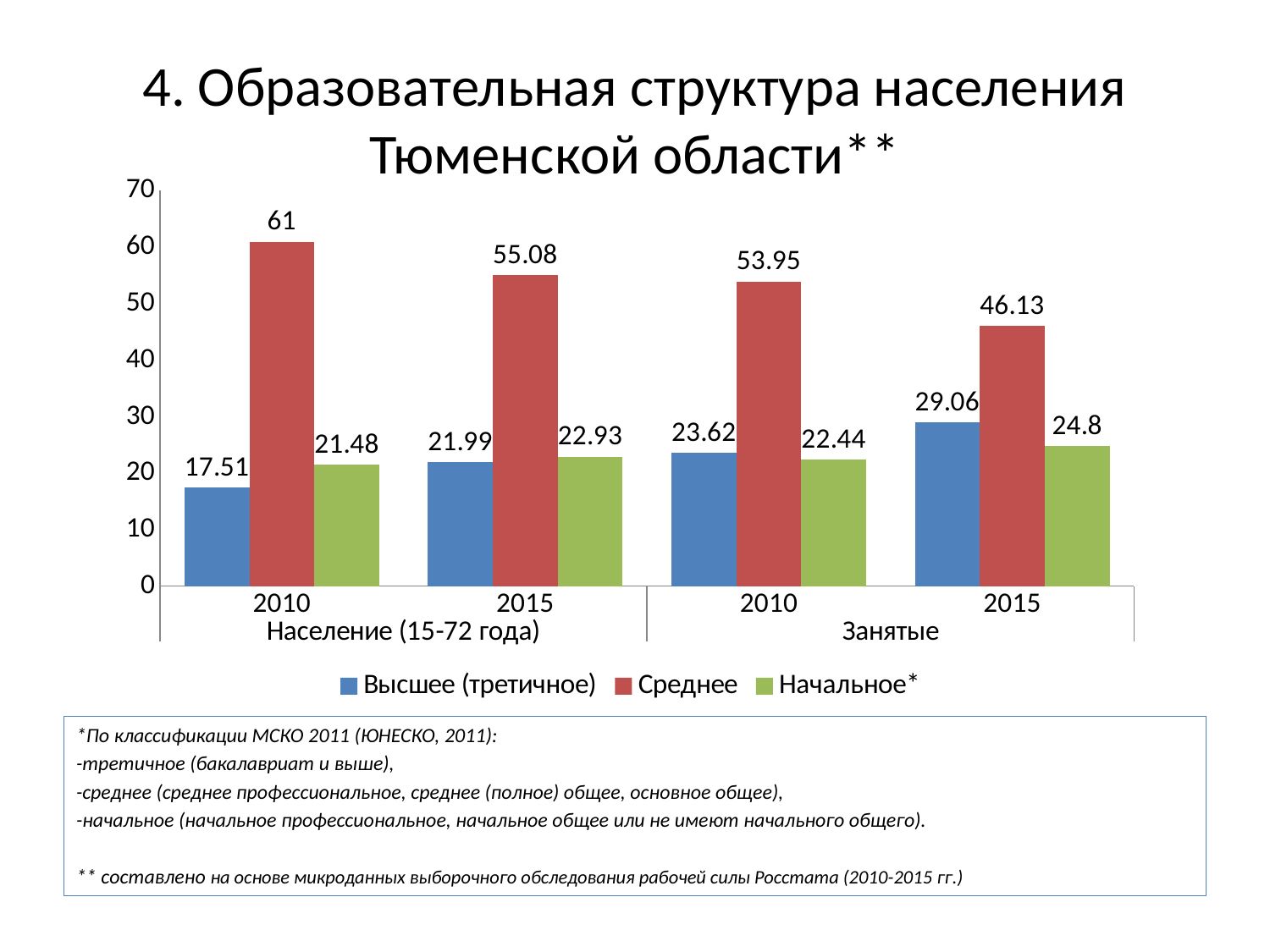
Which is larger for Занятые in 2010: Высшее (третичное) or Начальное*? Высшее (третичное) What is the value of Начальное* for Население (15-72 года) in 2015? 22.93 Is the value of Среднее for Занятые in 2010 greater or less than 50? greater What is the value of Высшее (третичное) for Население (15-72 года) in 2010? 17.51 Which group and year has the lowest value for Высшее (третичное)? Население (15-72 года), 2010 Does the value of Высшее (третичное) rise or fall from 2010 to 2015 for Занятые? Rise Which group and year has the highest value for Среднее? Население (15-72 года), 2010 What is the value of Высшее (третичное) for Занятые in 2015? 29.06 What is the value of Среднее for Занятые in 2015? 46.13 What is the difference between the Среднее values for Население (15-72 года) in 2010 and 2015? 5.92 How many series does the legend list? 3 What kind of chart is shown on the slide? Bar chart